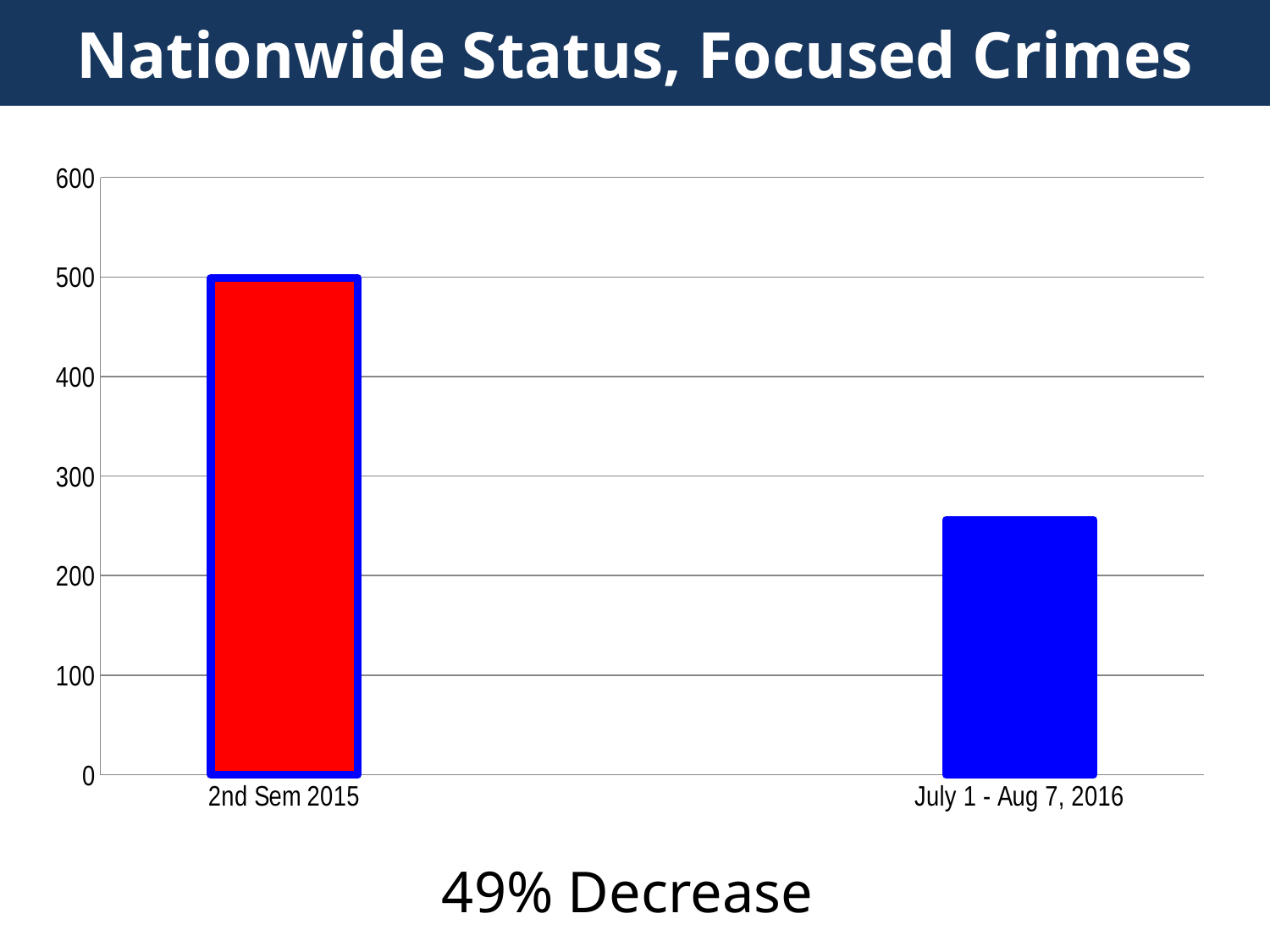
What percentage change is stated below the chart? 49% Decrease What is the title of the slide? Nationwide Status, Focused Crimes Do the values rise or fall from 2nd Sem 2015 to July 1 - Aug 7, 2016? fall Which category has the lowest value? July 1 - Aug 7, 2016 Is the value for July 1 - Aug 7, 2016 greater or less than 200? greater Is the value for July 1 - Aug 7, 2016 greater or less than 300? less Which category has the highest value? 2nd Sem 2015 How many bars are plotted in the chart? 2 Which is larger, the value for 2nd Sem 2015 or the value for July 1 - Aug 7, 2016? 2nd Sem 2015 Is the value for 2nd Sem 2015 greater or less than 400? greater What kind of chart is shown on the slide? bar chart